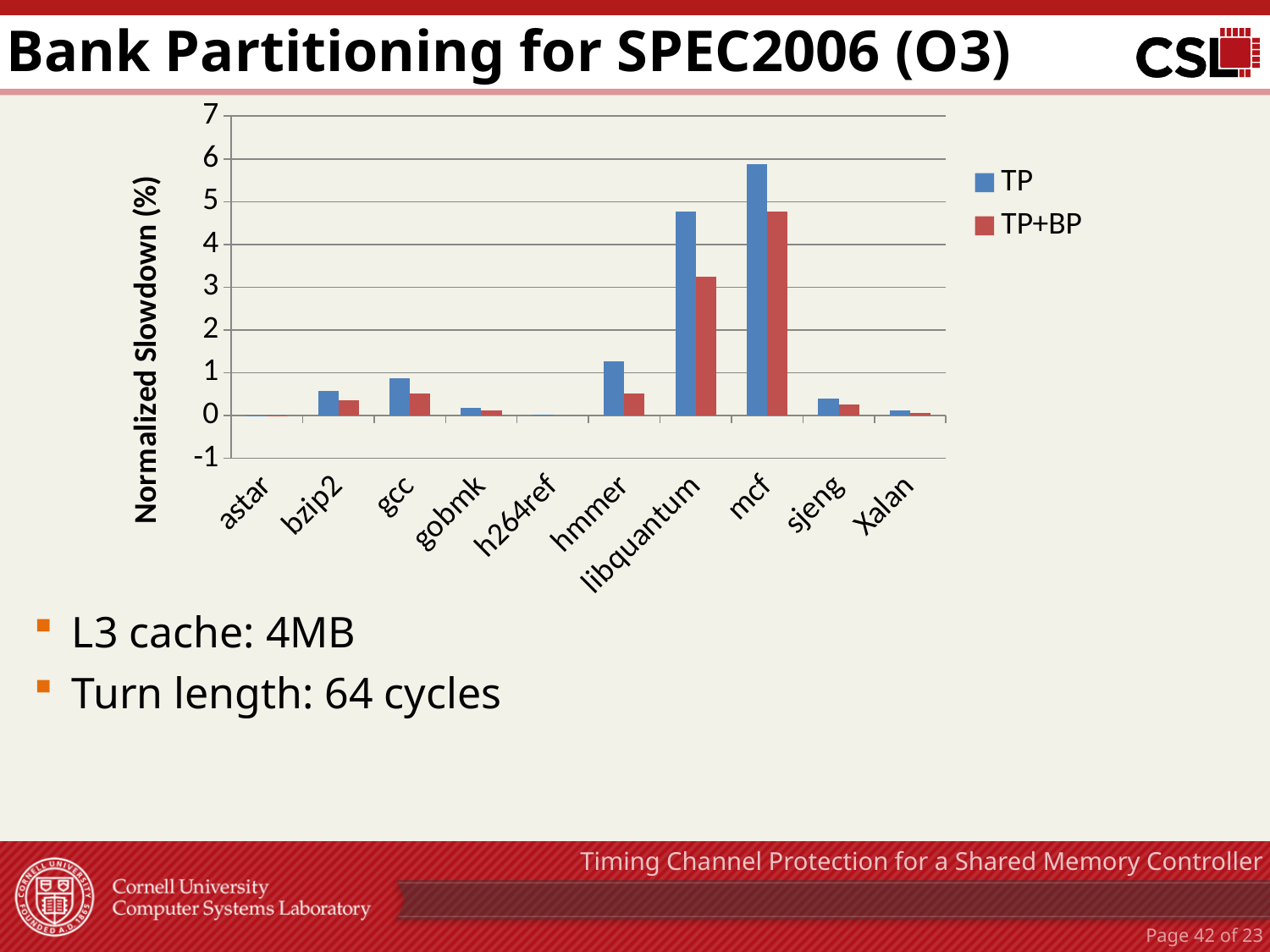
For libquantum, which series has the larger value, TP or TP+BP? TP Is the TP value for hmmer greater or less than 1? greater How many series does the legend list? 2 What is the label of the y axis? Normalized Slowdown (%) Which benchmark has the highest TP value? mcf How many benchmark categories are shown on the x axis? 10 Is the TP value for libquantum greater or less than 5? less Is the TP value for mcf greater or less than 5? greater What kind of chart is shown on the slide? bar chart For hmmer, which series has the larger value, TP or TP+BP? TP Which benchmark has the highest TP+BP value? mcf